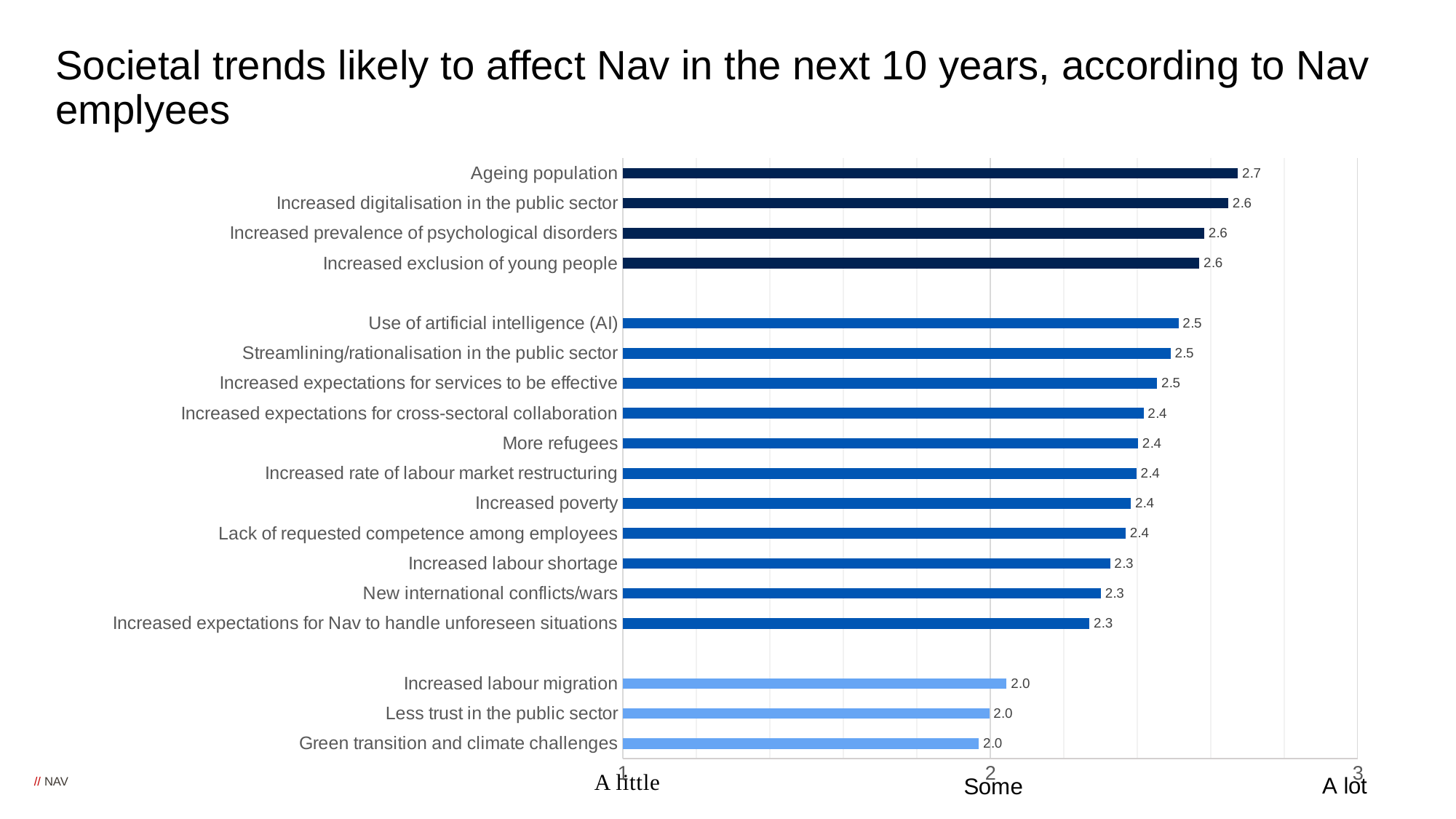
What kind of chart is shown on the slide? bar chart Which category has the highest value? Ageing population What is the value for Green transition and climate challenges? 2.0 What is the value for Ageing population? 2.7 What is the value for Increased labour shortage? 2.3 What label appears at the right end of the x axis, at the value 3? A lot Which is larger, the value for Ageing population or the value for Increased labour migration? Ageing population Is the value for Use of artificial intelligence (AI) greater or less than 2? greater What is the difference between the values for Increased digitalisation in the public sector and Increased poverty? 0.2 What is the value for Use of artificial intelligence (AI)? 2.5 How many categories are shown in the chart? 18 What is the difference between the values for Ageing population and Green transition and climate challenges? 0.7